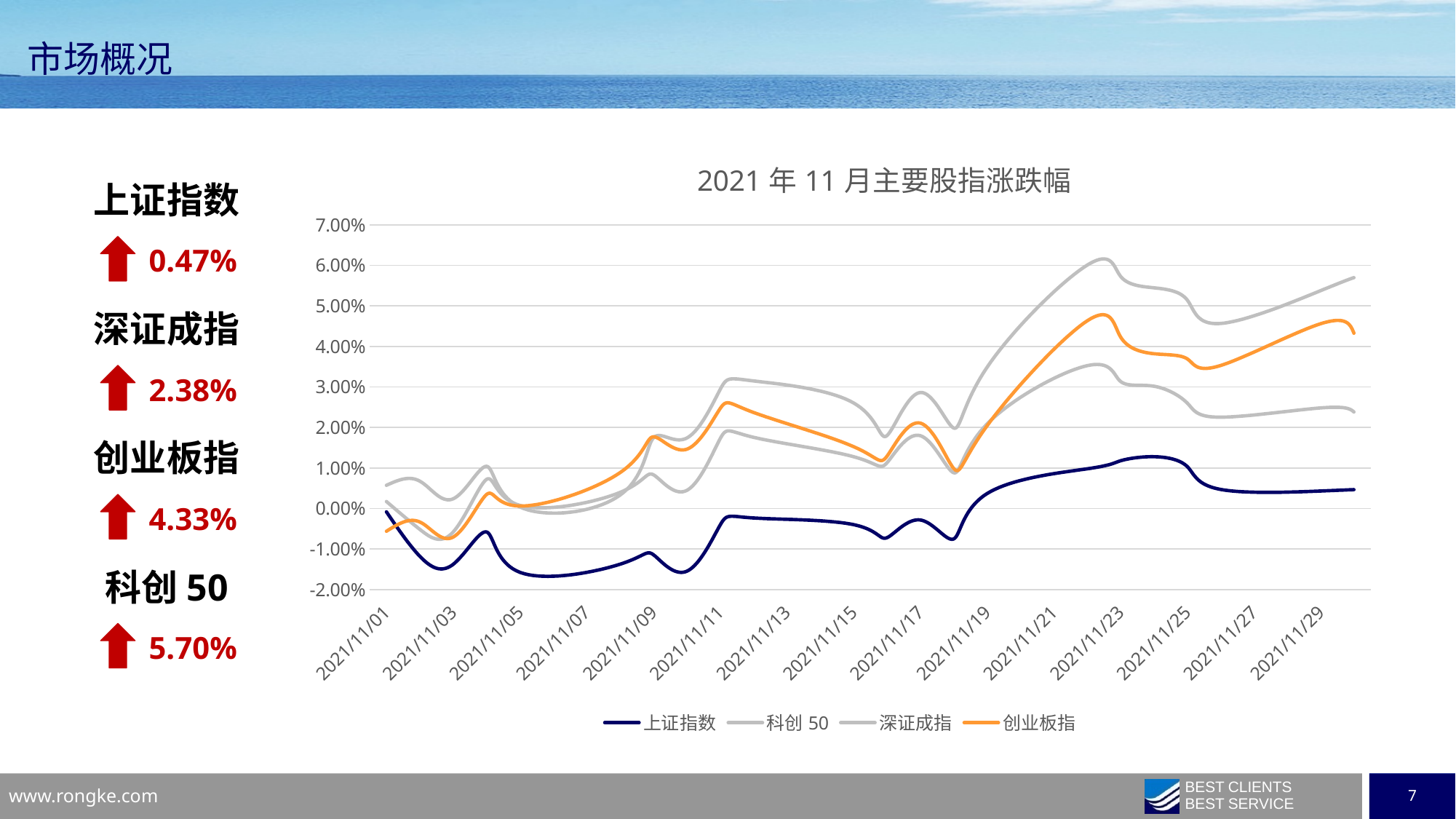
How many series does the chart legend list? 4 What type of chart is shown on the slide? line chart According to the slide, what is the November 2021 change for 上证指数? 0.47% Is the value for 上证指数 at 2021/11/05 greater or less than -1.00%? less According to the slide, what is the November 2021 change for 创业板指? 4.33% Is the value for 创业板指 at 2021/11/23 greater or less than 4.00%? greater What is the difference between the monthly change of 科创 50 and that of 上证指数? 5.23% Which index ends the month with the lowest cumulative change? 上证指数 What is the title of the chart? 2021 年 11 月主要股指涨跌幅 Which series is drawn in orange in the chart? 创业板指 Which has the larger monthly change, 创业板指 or 深证成指? 创业板指 Which index ends the month with the highest cumulative change? 科创 50